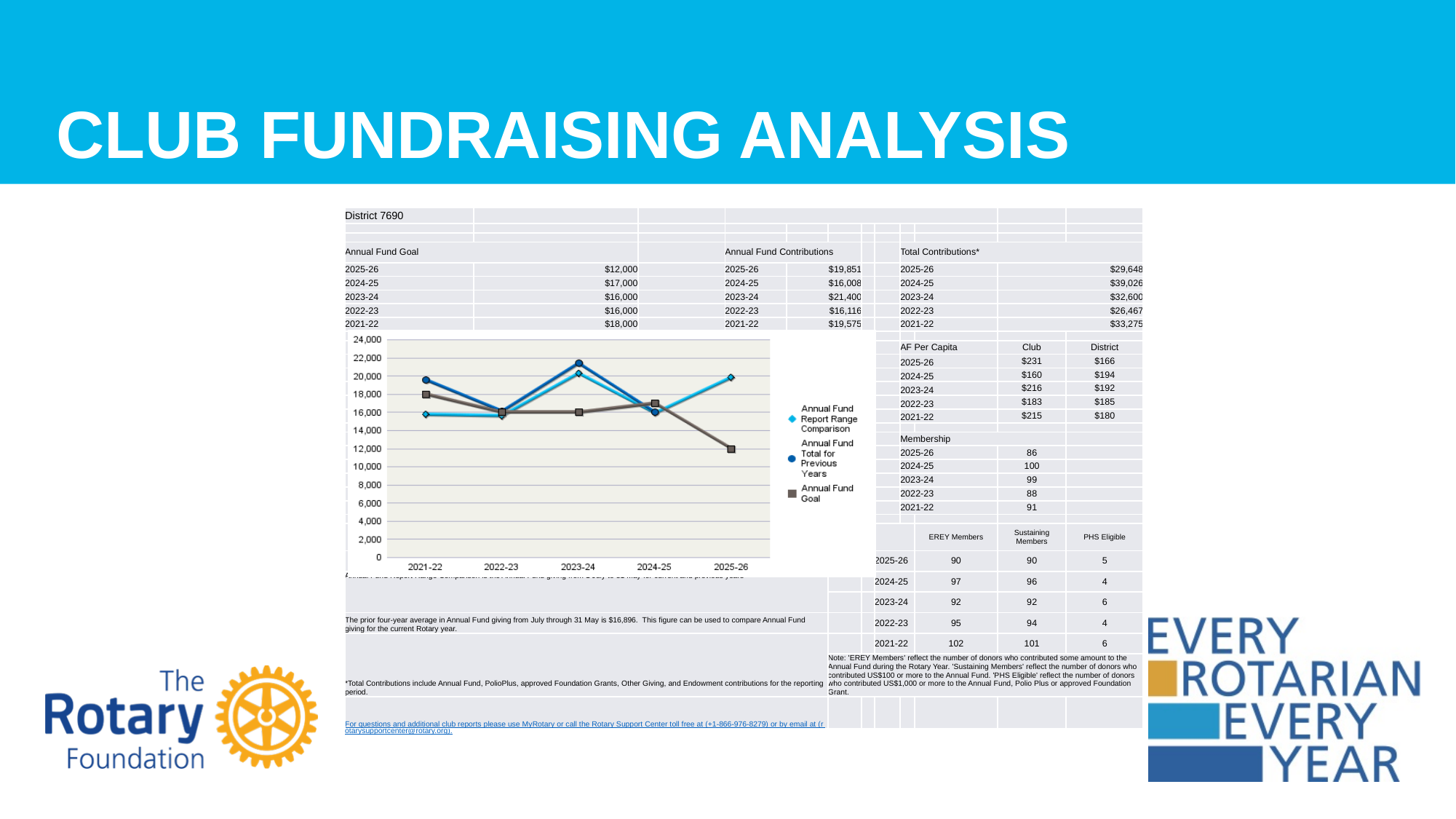
Which year has the lowest Annual Fund Goal on the chart? 2025-26 What is the Annual Fund Goal value plotted for 2025-26? 12,000 How many series does the chart's legend list? 3 In 2023-24, which is higher: the Annual Fund Total for Previous Years or the Annual Fund Goal? Annual Fund Total for Previous Years Is the Annual Fund Report Range Comparison value for 2025-26 greater or less than 18,000? greater How many Rotary years are shown along the x axis of the chart? 5 What kind of chart is shown on the slide? Line chart Which year has the highest Annual Fund Goal on the chart? 2021-22 Does the Annual Fund Goal line rise or fall from 2024-25 to 2025-26? Fall What is the Annual Fund Goal value plotted for 2021-22? 18,000 Is the Annual Fund Report Range Comparison value for 2022-23 greater or less than 18,000? less Is the Annual Fund Total for Previous Years value for 2023-24 greater or less than 20,000? greater